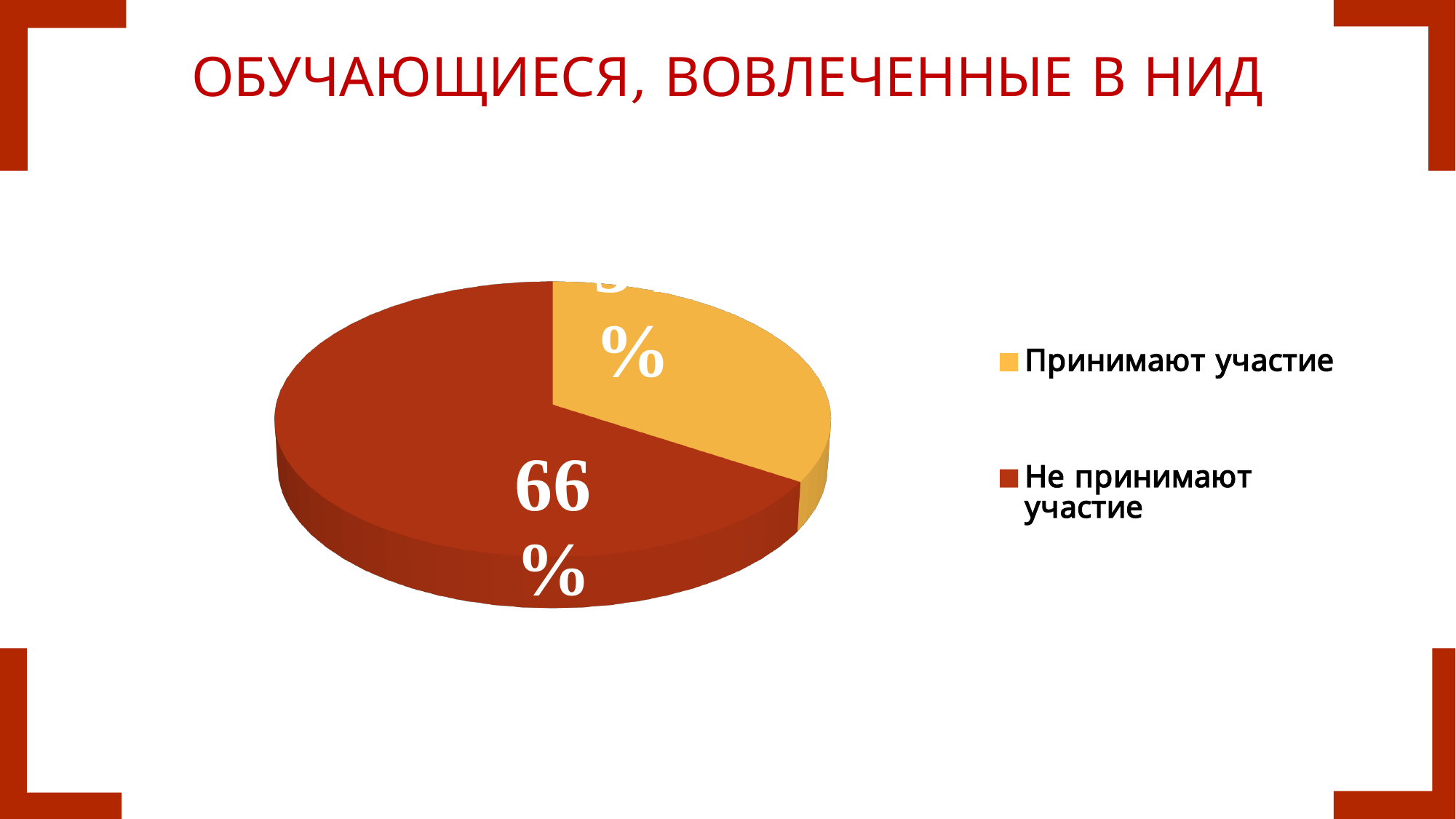
How many entries does the legend list? 2 What is the value shown for the "Не принимают участие" slice? 66% Which slice of the pie is the smallest? Принимают участие Which slice of the pie is the largest? Не принимают участие What kind of chart is shown on the slide? Pie chart Is the share for "Принимают участие" greater or less than 50%? less What colour is the "Принимают участие" slice? Yellow Which is larger: the "Принимают участие" slice or the "Не принимают участие" slice? Не принимают участие How many slices does the pie chart have? 2 What is the title of the slide containing the chart? ОБУЧАЮЩИЕСЯ, ВОВЛЕЧЕННЫЕ В НИД Is the share for "Не принимают участие" greater or less than 50%? greater